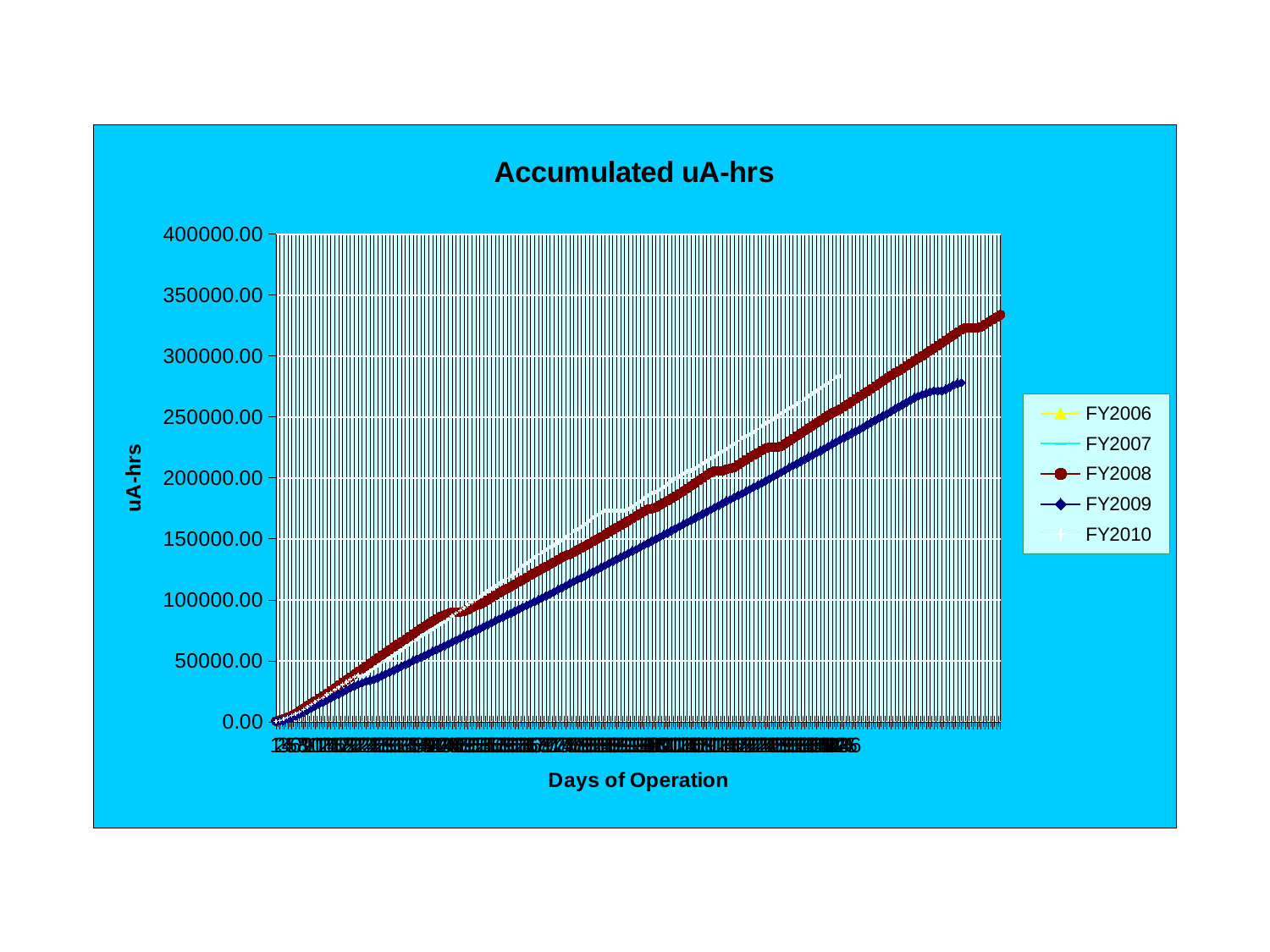
At the end of their plotted ranges, which line is higher, FY2008 or FY2009? FY2008 What is the label of the x axis? Days of Operation What is the highest tick value shown on the y axis? 400000.00 What kind of chart is shown on the slide? line chart Which series reaches the highest accumulated uA-hrs value on the chart? FY2008 Is the final value of the FY2008 line greater or less than 300000.00? greater How many series does the legend list? 5 Do the plotted values for FY2009 rise or fall along the x axis? rise Do the plotted values for FY2008 rise or fall as the days of operation increase? rise Is the final value of the FY2009 line greater or less than 300000.00? less What is the title of the chart? Accumulated uA-hrs Is the final value of the FY2008 line greater or less than 350000.00? less